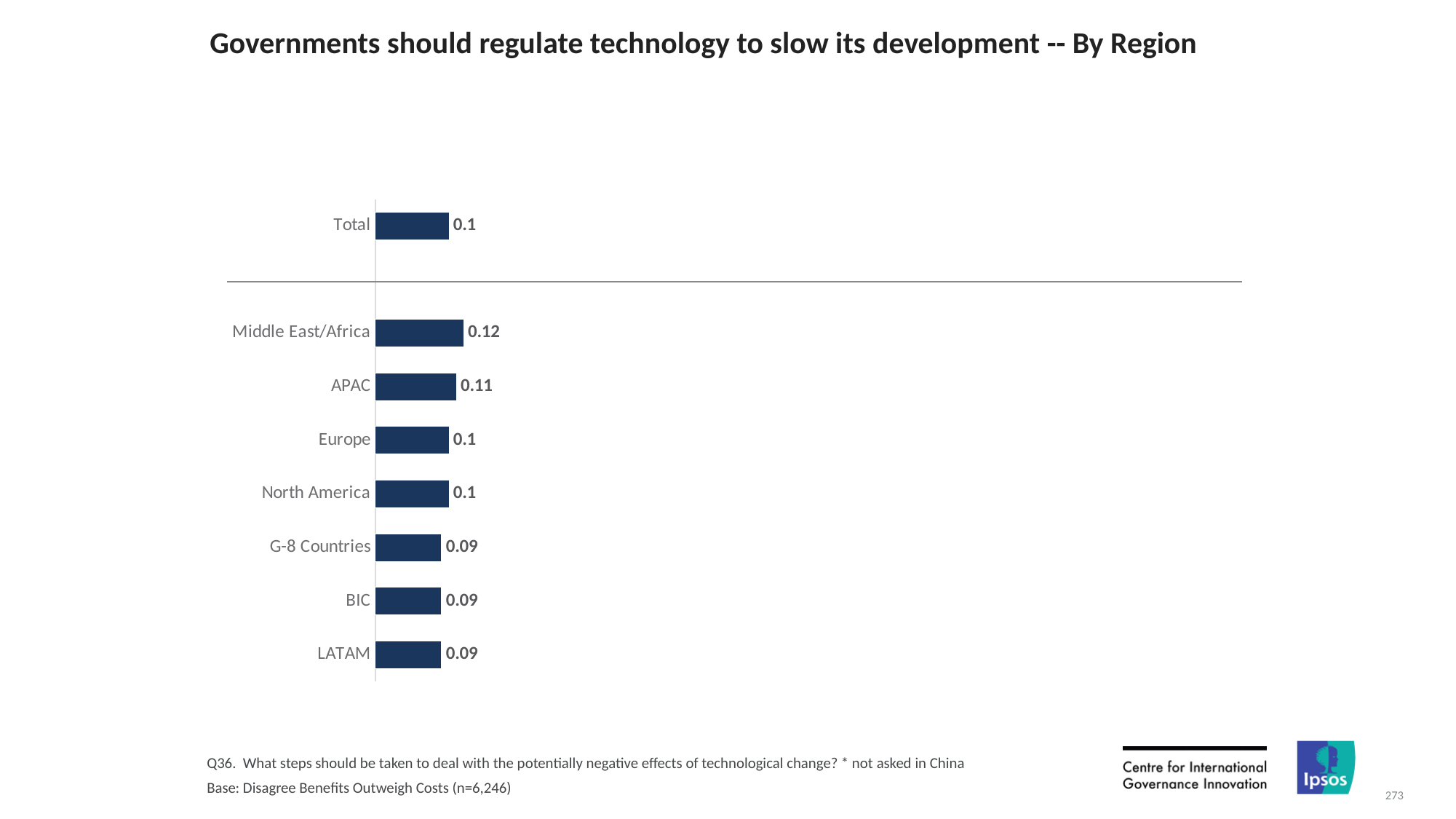
What is the value for LATAM? 0.09 What is the difference between the values for Middle East/Africa and LATAM? 0.03 How many bars are shown in the chart, including Total? 8 Which region has the highest value? Middle East/Africa What is the title of the chart? Governments should regulate technology to slow its development -- By Region What is the value for APAC? 0.11 What is the value for Total? 0.1 What is the value for Middle East/Africa? 0.12 Which is larger, the value for APAC or the value for Europe? APAC What kind of chart is shown on the slide? Bar chart What is the difference between the values for Middle East/Africa and APAC? 0.01 What is the value for G-8 Countries? 0.09